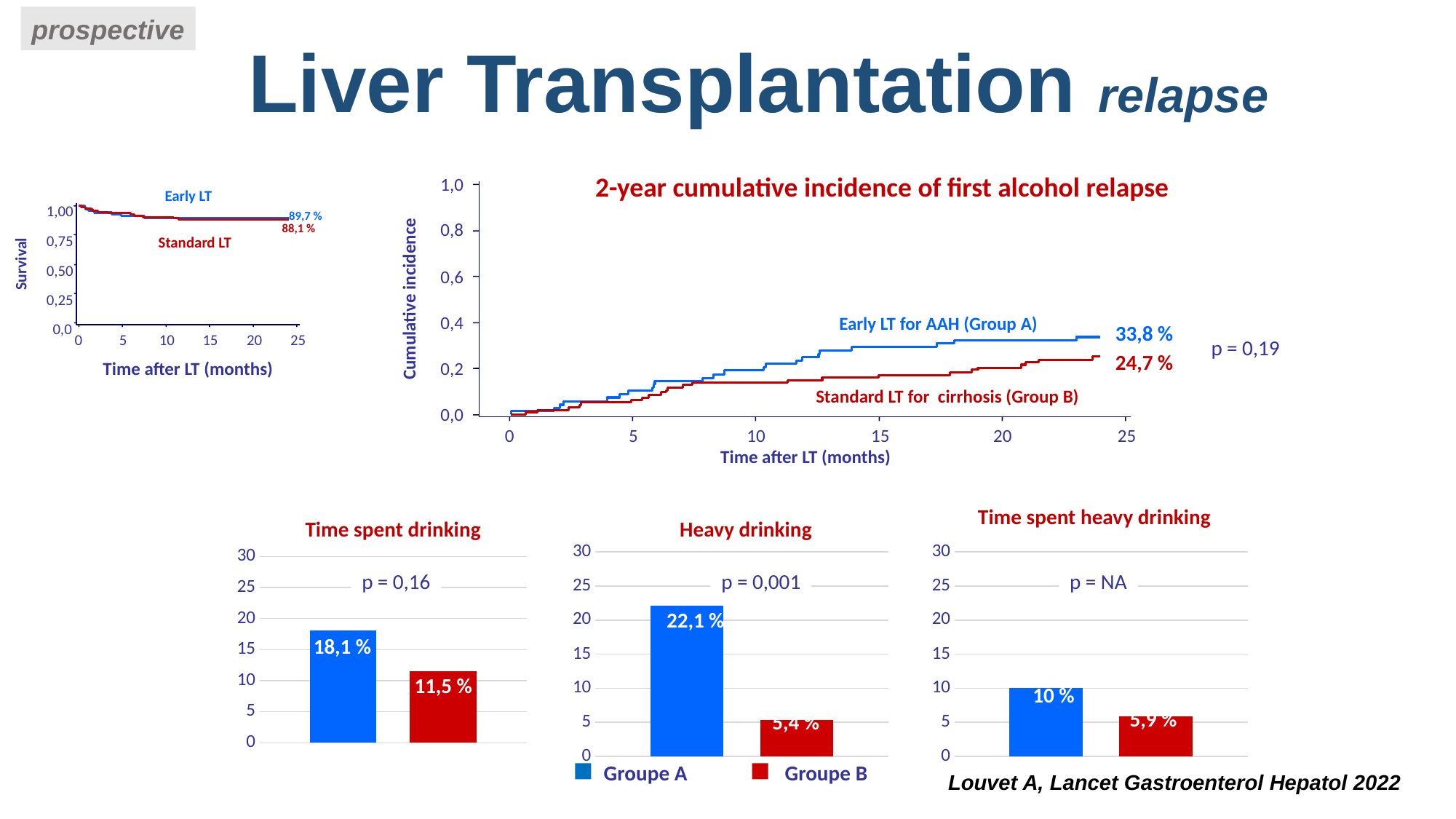
In the 'Heavy drinking' chart, what is the value for Groupe A? 22,1 % In the 'Time spent heavy drinking' chart, what is the value for Groupe A? 10 % What kind of chart is the 'Heavy drinking' chart? bar chart In the 'Time spent drinking' chart, what is the difference between Groupe A and Groupe B? 6,6 % In the 'Heavy drinking' chart, what is the value for Groupe B? 5,4 % In the '2-year cumulative incidence of first alcohol relapse' chart, what is the final value for Early LT for AAH (Group A)? 33,8 % In the '2-year cumulative incidence of first alcohol relapse' chart, what is the final value for Standard LT for cirrhosis (Group B)? 24,7 % In the 'Heavy drinking' chart, is the value for Groupe A greater or less than 20? greater In the 'Time spent drinking' chart, what is the value for Groupe A? 18,1 % In the 'Time spent heavy drinking' chart, what is the value for Groupe B? 5,9 % In the 'Heavy drinking' chart, which group has the higher value? Groupe A In the 'Time spent drinking' chart, what is the value for Groupe B? 11,5 %